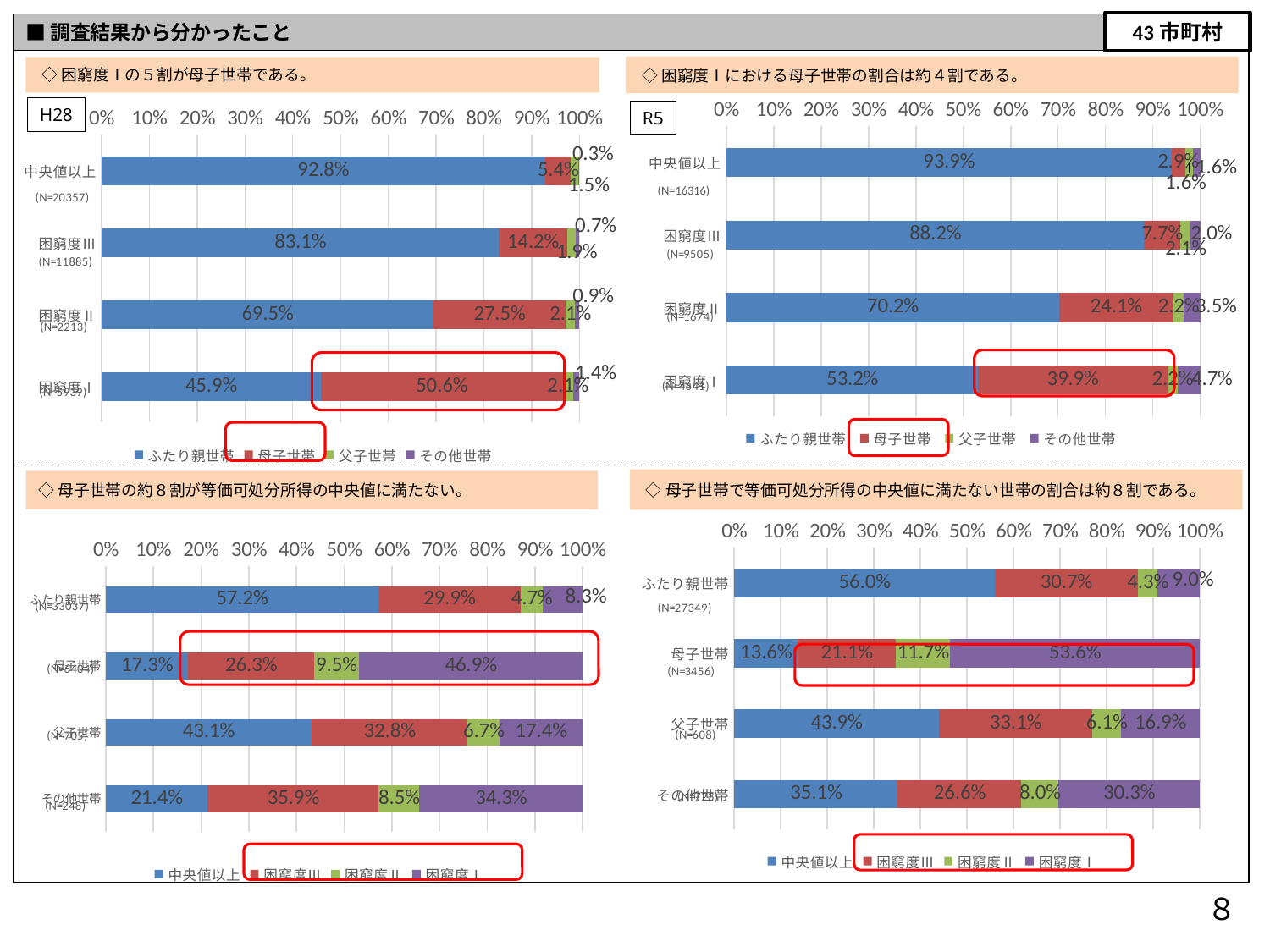
How many categories are shown in the bottom-right (R5) chart? 4 In the bottom-left (H28) chart, what is the value for 困窮度Ⅰ in the 母子世帯 category? 46.9% What kind of chart is the top-right (R5) chart? Stacked bar chart In the bottom-left (H28) chart, what is the total of the stacked bar for その他世帯? 100.1% In the top-right (R5) chart, what is the difference between the 母子世帯 values for 困窮度Ⅰ and 困窮度Ⅱ? 15.8% In the bottom-right (R5) chart, which category has the lowest value for 中央値以上? 母子世帯 In the top-right (R5) chart, what is the value for ふたり親世帯 in the 困窮度Ⅰ category? 53.2% In the top-left (H28) chart, which category has the highest value for ふたり親世帯? 中央値以上 In the bottom-right (R5) chart, what is the value for 困窮度Ⅰ in the 母子世帯 category? 53.6% In the bottom-left (H28) chart, which is larger for 父子世帯: 中央値以上 or 困窮度Ⅲ? 中央値以上 How many series does the legend of the top-left (H28) chart list? 4 In the top-left (H28) chart, what is the value for 母子世帯 in the 困窮度Ⅰ category? 50.6%